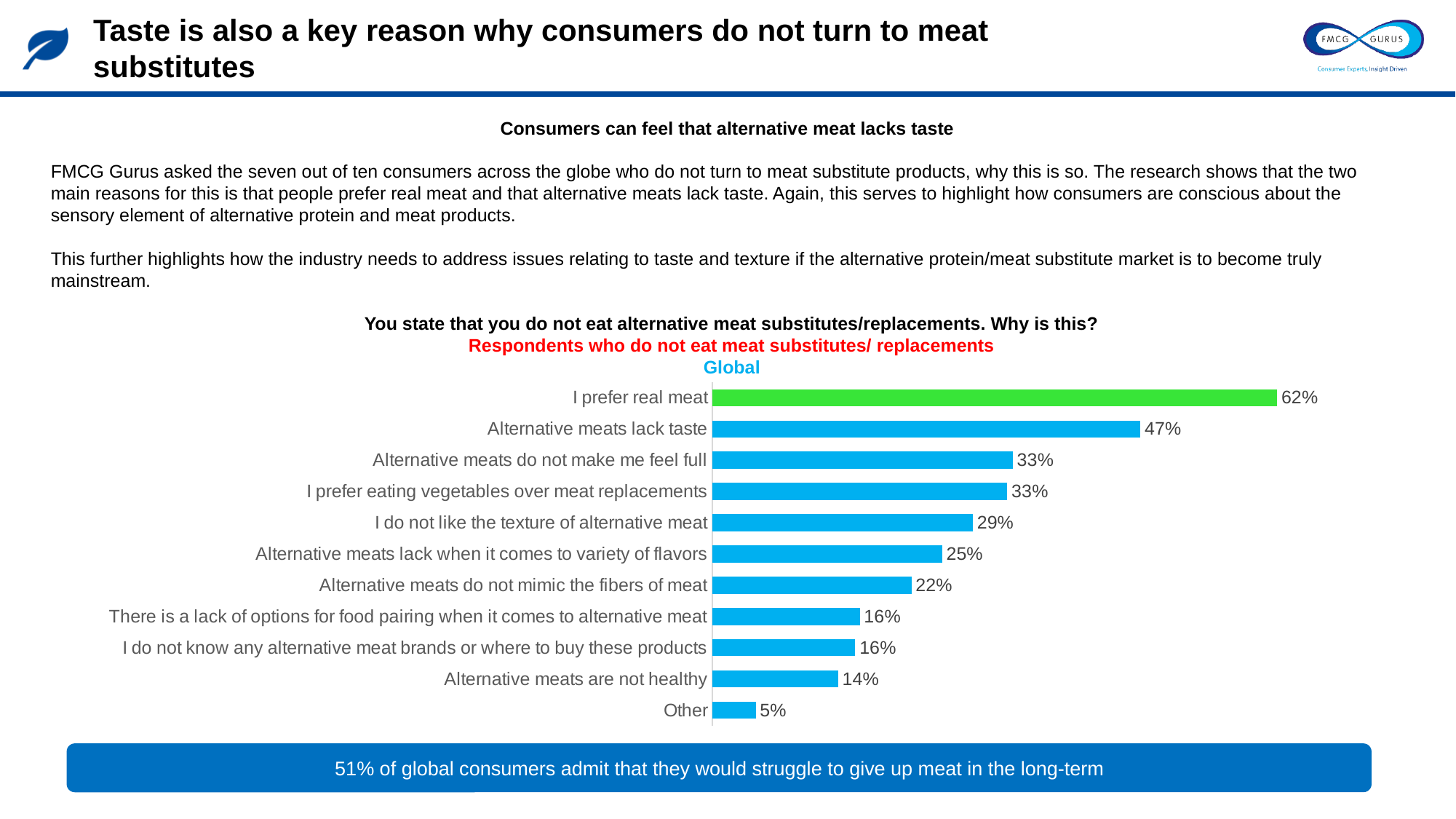
What is the value for "Alternative meats are not healthy"? 14% What percentage of respondents said "I do not like the texture of alternative meat"? 29% What is the value for "Alternative meats lack taste"? 47% What percentage of respondents said "I prefer real meat"? 62% Which category has the lowest value? Other What type of chart is shown on the slide? Bar chart What is the difference between "Alternative meats do not make me feel full" and "Other"? 28 percentage points Which reason has the highest percentage? I prefer real meat Which is larger: "Alternative meats lack when it comes to variety of flavors" or "Alternative meats do not mimic the fibers of meat"? Alternative meats lack when it comes to variety of flavors What is the difference between "I prefer real meat" and "Alternative meats lack taste"? 15 percentage points How many categories are shown in the chart? 11 Which bar in the chart is coloured green? I prefer real meat